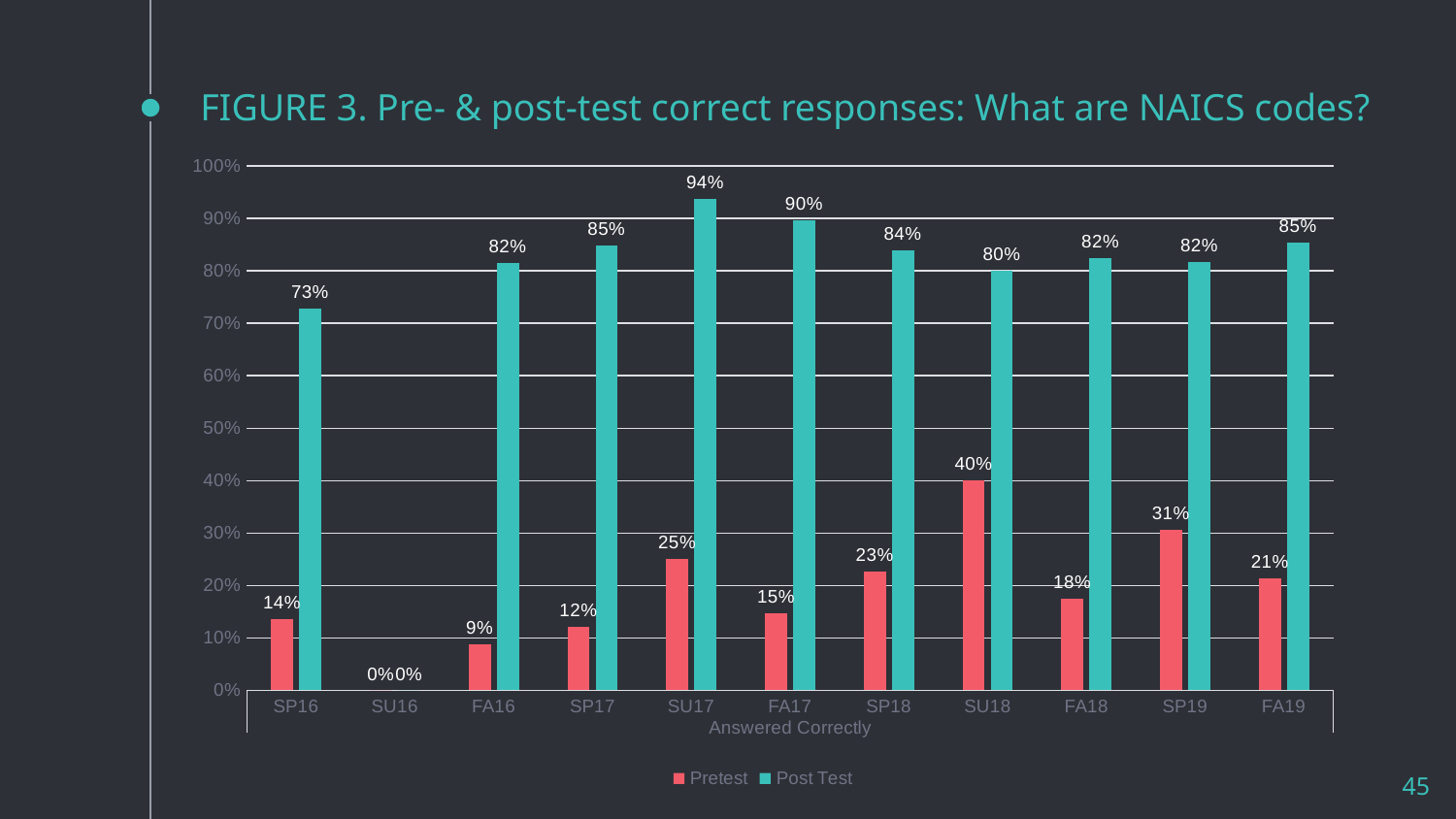
Which is larger, the Pretest value for SP19 or the Pretest value for SP18? SP19 What is the Pretest value for FA16? 9% What is the x-axis title of the chart? Answered Correctly What is the Post Test value for SU17? 94% What is the Pretest value for SU18? 40% What kind of chart is shown on the slide? bar chart How many categories are shown on the x axis? 11 Which category has the highest Post Test value? SU17 Is the Post Test value for FA17 greater or less than 80%? greater Which category has the lowest Pretest value? SU16 What is the difference between the Post Test and Pretest values for SP16? 59% How many series does the legend list? 2